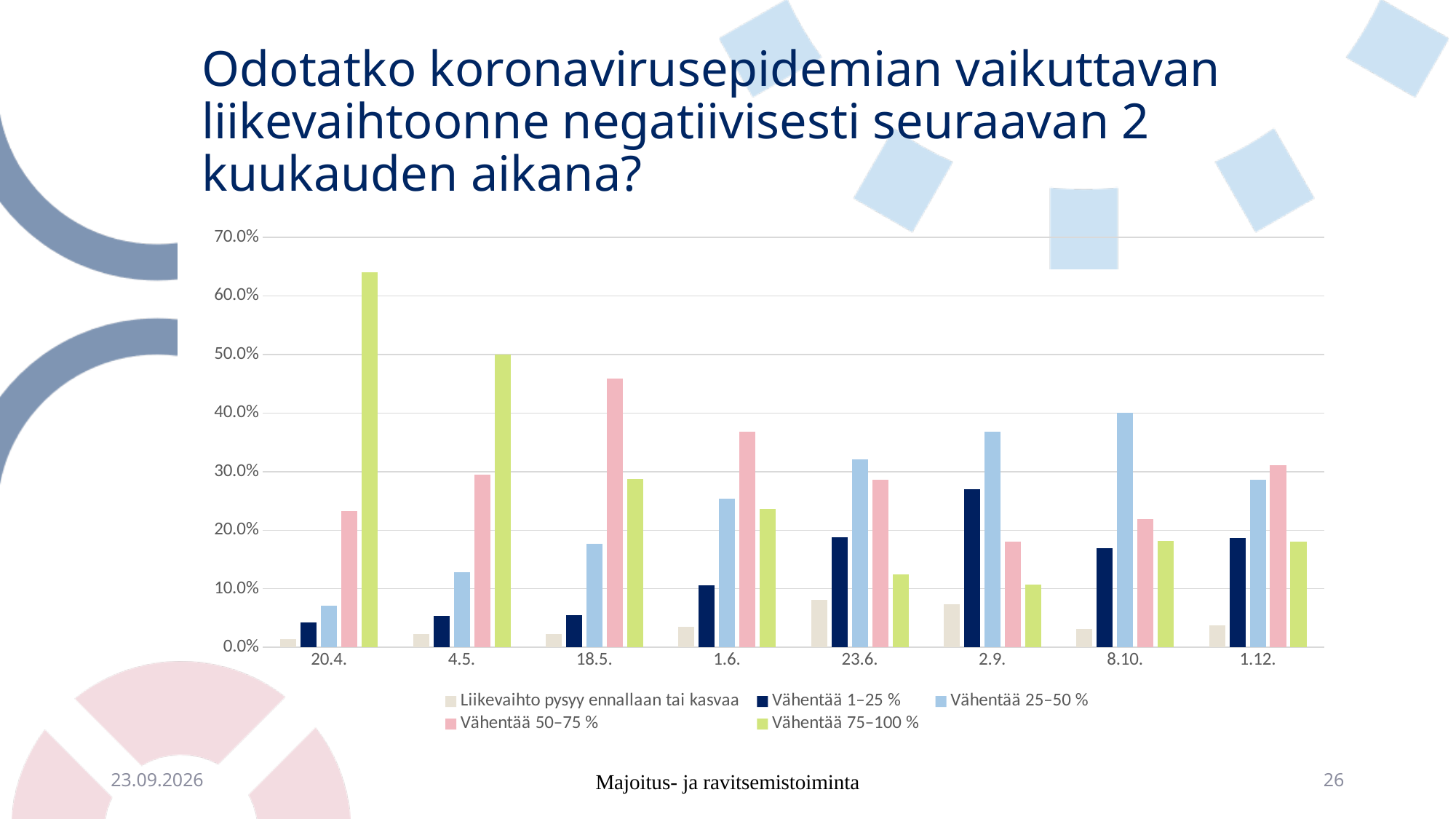
How many series does the chart's legend list? 5 How many dates are shown on the x axis of the chart? 8 Does the value for Vähentää 75–100 % rise or fall from 20.4. to 23.6.? fall What kind of chart is shown on the slide? bar chart Is the value for Vähentää 25–50 % on 8.10. greater or less than 30.0%? greater Is the value for Vähentää 75–100 % on 20.4. greater or less than 60.0%? greater On which date is the value for Vähentää 25–50 % highest? 8.10. Is the value for Vähentää 50–75 % on 18.5. greater or less than 40.0%? greater Which series has the tallest bar on 2.9.? Vähentää 25–50 % On which date is the value for Vähentää 75–100 % highest? 20.4. What colour represents the Vähentää 75–100 % series in the chart? green On 8.10., which is larger: Vähentää 25–50 % or Vähentää 50–75 %? Vähentää 25–50 %